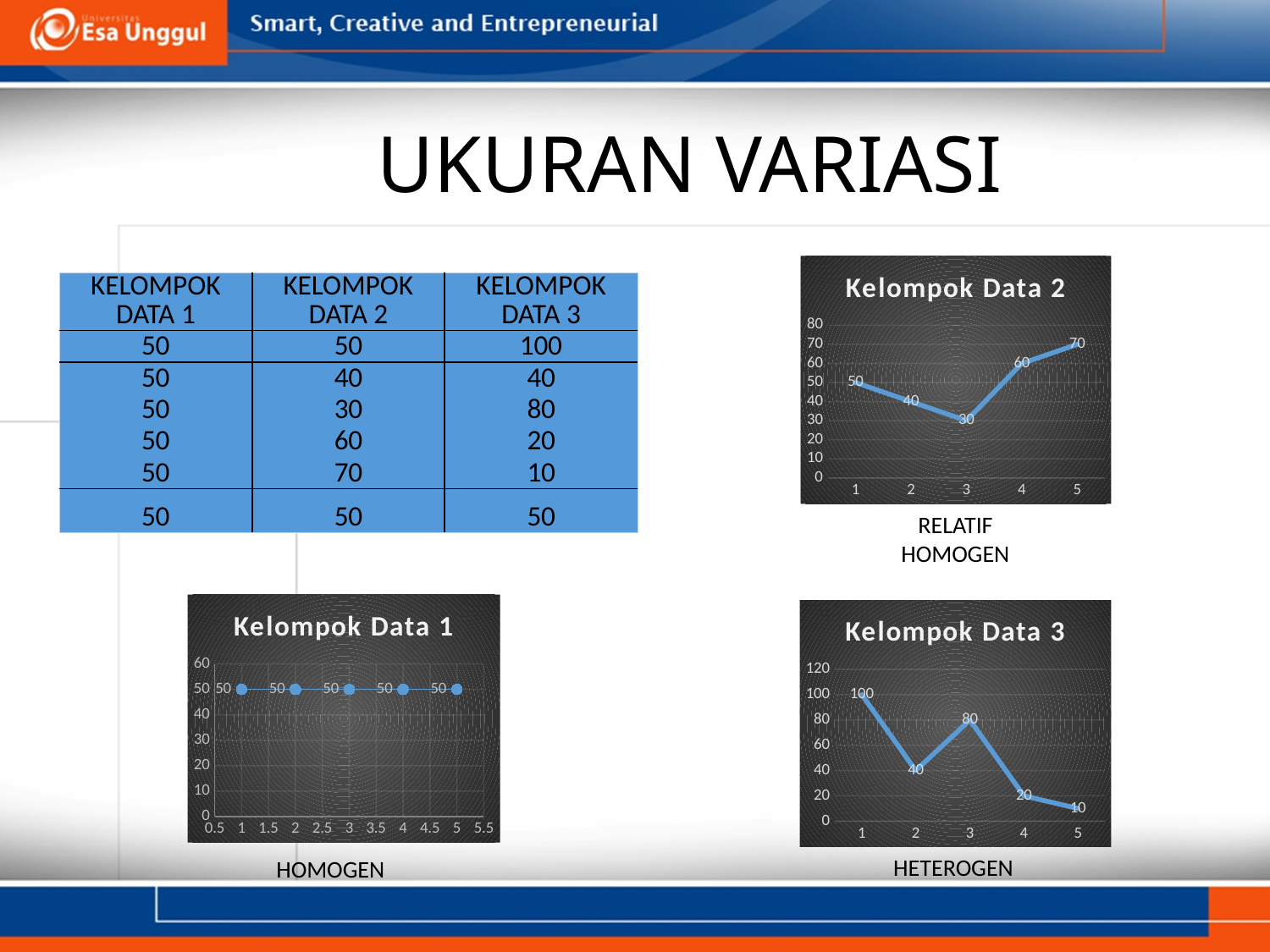
In the chart titled "Kelompok Data 2", what is the value at point 5? 70 In the chart titled "Kelompok Data 3", what is the difference between the values at point 1 and point 5? 90 What kind of chart is the chart titled "Kelompok Data 2"? Line chart In the chart titled "Kelompok Data 3", which point has the highest value? 1 In the chart titled "Kelompok Data 3", do the values generally rise or fall from point 1 to point 5? Fall In the chart titled "Kelompok Data 2", what is the difference between the values at point 5 and point 3? 40 In the chart titled "Kelompok Data 1", what value do all the plotted points have? 50 In the chart titled "Kelompok Data 3", is the value at point 3 larger than the value at point 2? Yes How many data points are plotted in the chart titled "Kelompok Data 1"? 5 In the chart titled "Kelompok Data 3", which point has the lowest value? 5 In the chart titled "Kelompok Data 3", what is the value at point 1? 100 In the chart titled "Kelompok Data 2", which point has the lowest value? 3